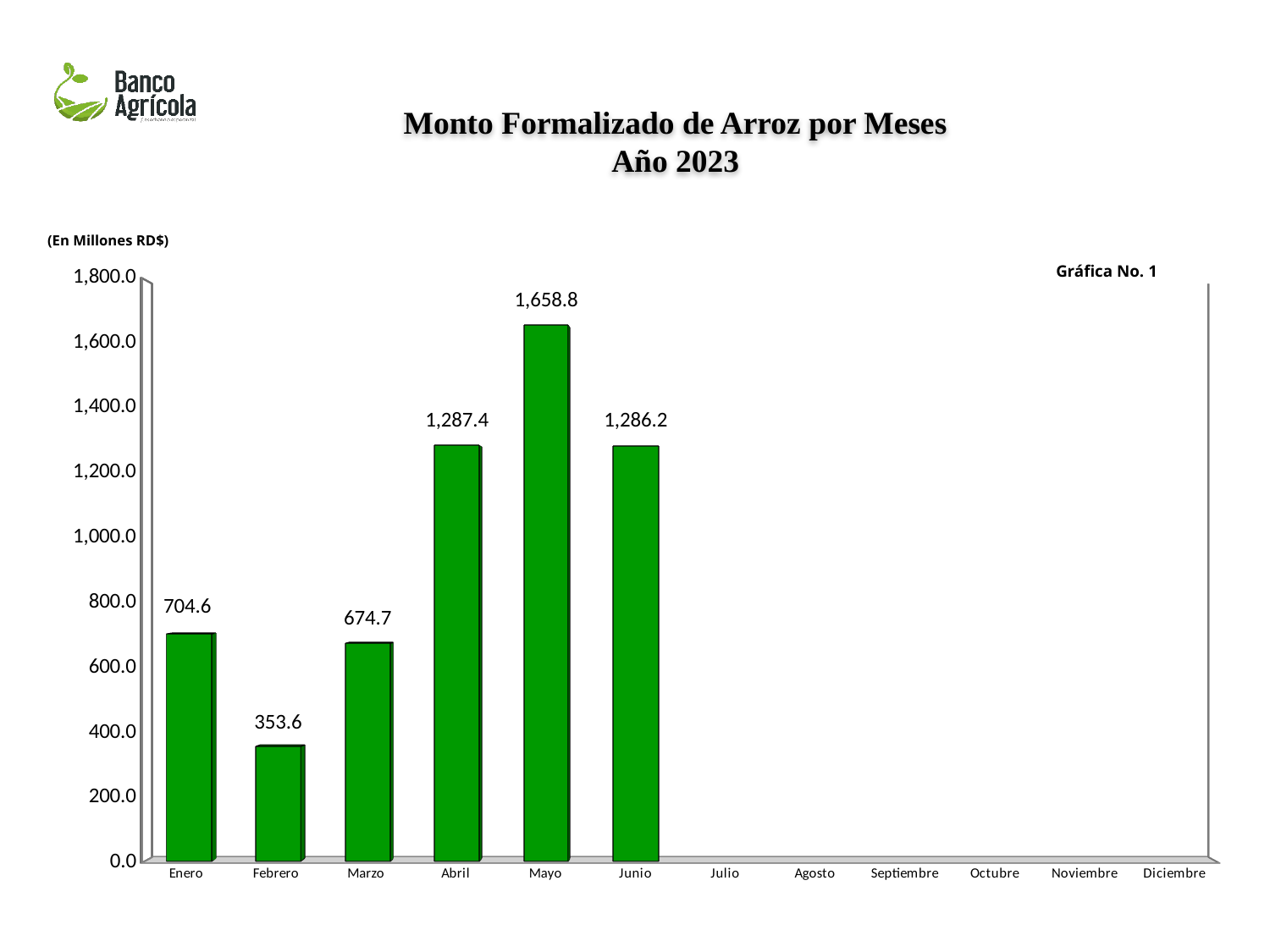
Which month has the highest value? Mayo What is the difference between the values for Enero and Febrero? 351.0 What kind of chart is shown on the slide? bar chart What is the difference between the values for Mayo and Abril? 371.4 How many months have a bar plotted on the chart? 6 What is the value for Febrero? 353.6 Which is larger, the value for Enero or the value for Marzo? Enero Is the value for Febrero greater or less than 400.0? less What is the value for Abril? 1,287.4 What is the value for Mayo? 1,658.8 Which month has the lowest value among the months with bars? Febrero What unit is stated for the values on the chart? En Millones RD$